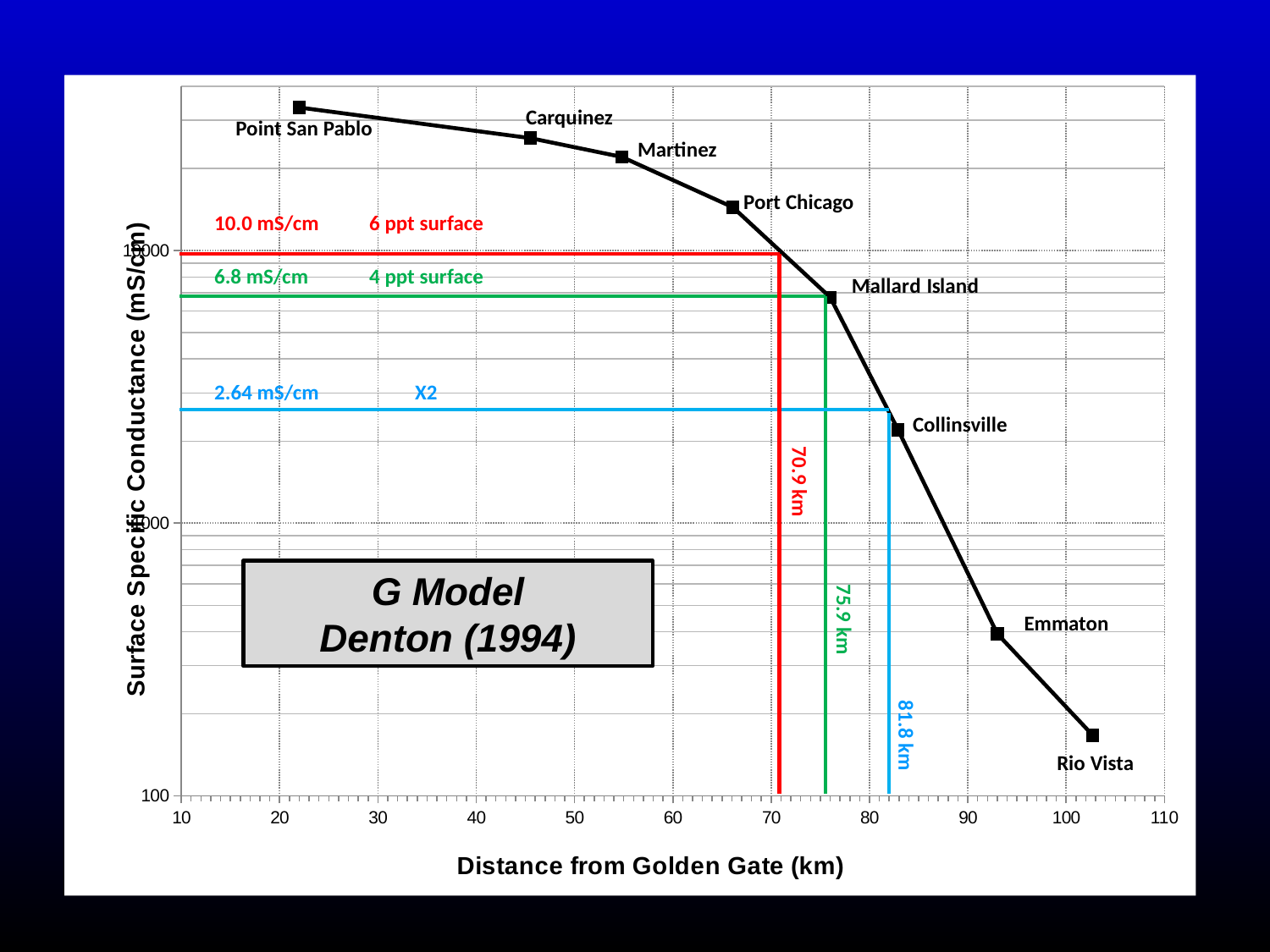
What is the difference in distance between the X2 line (81.8 km) and the 10.0 mS/cm line (70.9 km)? 10.9 km Which station has the lowest surface specific conductance? Rio Vista At what distance from the Golden Gate does the 6.8 mS/cm (4 ppt surface) line intersect the curve? 75.9 km How many labeled station points are plotted on the line? 8 Which has the higher surface specific conductance, Collinsville or Emmaton? Collinsville At what distance from the Golden Gate is X2 located according to the chart? 81.8 km What conductance value is associated with X2 on the chart? 2.64 mS/cm At what distance from the Golden Gate does the 10.0 mS/cm (6 ppt surface) line intersect the curve? 70.9 km Is the surface specific conductance at Emmaton greater or less than 1000? less What kind of chart is shown on the slide? line chart Does surface specific conductance rise or fall as distance from the Golden Gate increases? fall Which station has the highest surface specific conductance? Point San Pablo